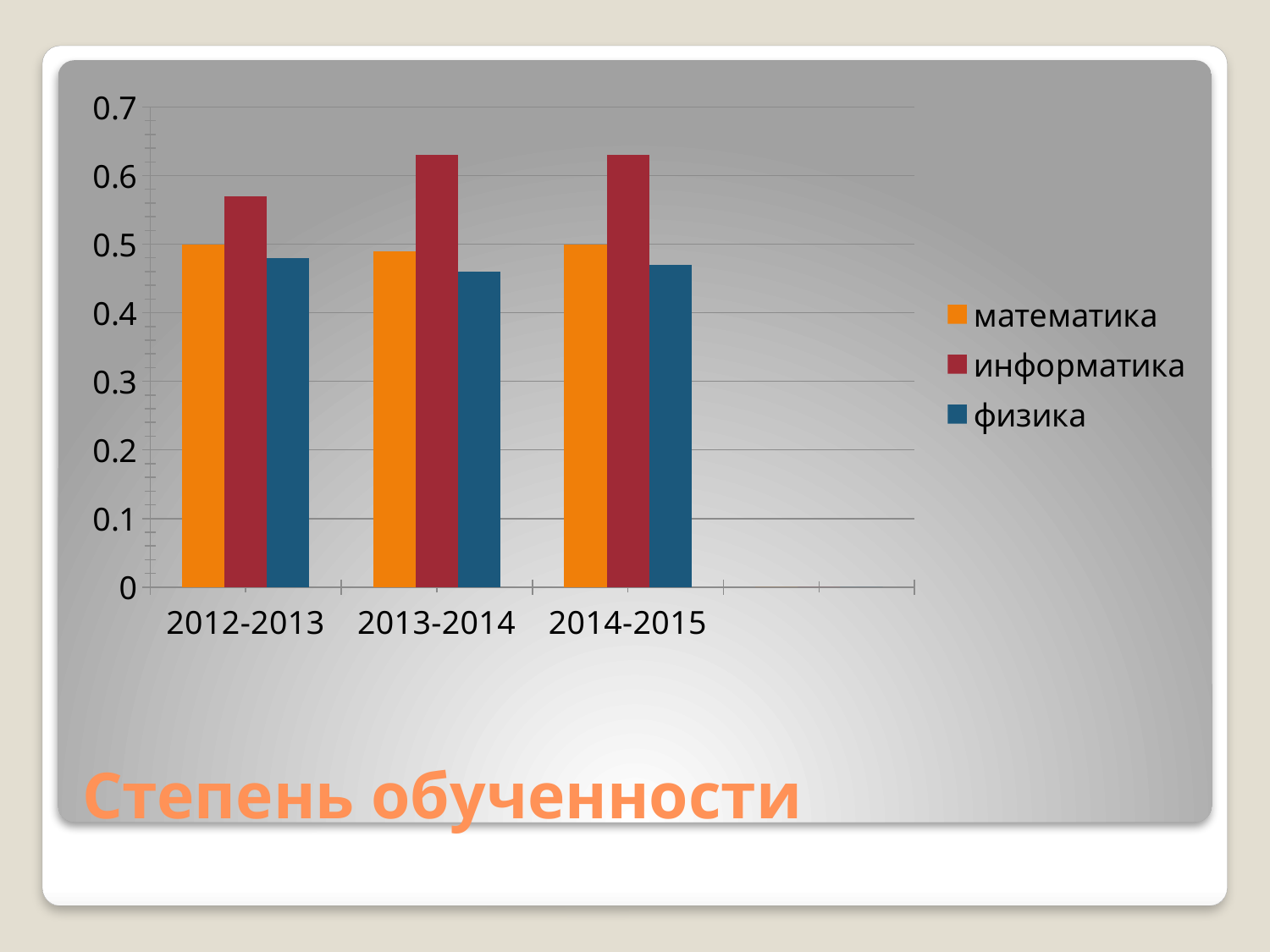
Which subject has the highest bar in every year shown? информатика How many series does the legend list? 3 Which subject has the lowest value in 2012-2013? физика Which subject has the highest value in 2013-2014? информатика What kind of chart is shown on the slide? bar chart How many school-year categories are shown on the x axis? 3 Is the value for физика in 2013-2014 greater or less than 0.5? less Is the value for информатика in 2012-2013 greater or less than 0.5? greater Does the value for информатика rise or fall from 2012-2013 to 2013-2014? rise Is the value for информатика in 2012-2013 larger or smaller than its value in 2013-2014? smaller What is the title shown on the slide? Степень обученности Is the value for информатика in 2013-2014 greater or less than 0.6? greater